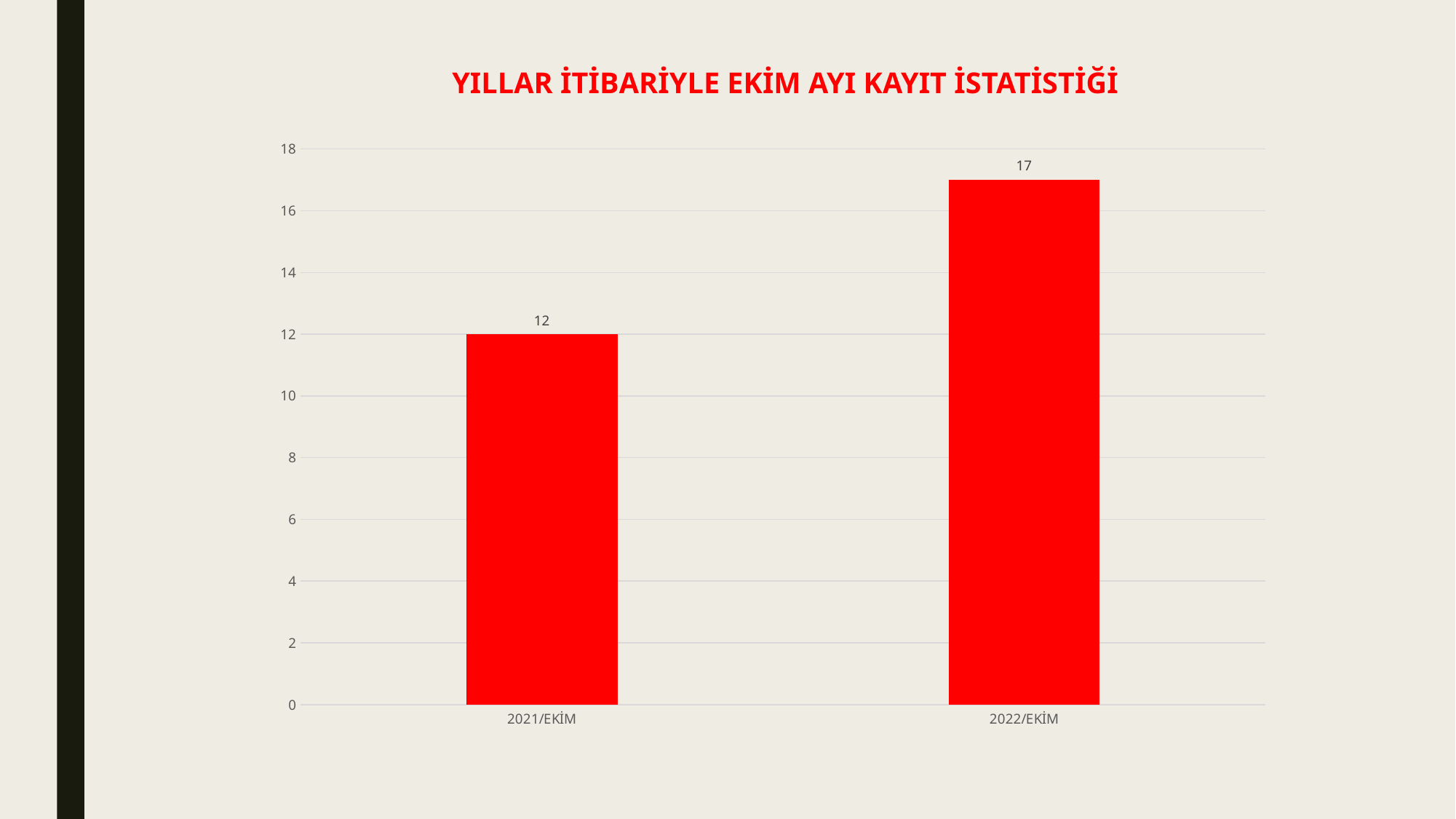
What is the difference between the values for 2022/EKİM and 2021/EKİM? 5 Which category has the lowest value? 2021/EKİM What is the title of the chart? YILLAR İTİBARİYLE EKİM AYI KAYIT İSTATİSTİĞİ Do the values rise or fall from 2021/EKİM to 2022/EKİM? rise Which category has the highest value? 2022/EKİM Is the value for 2022/EKİM greater or less than 16? greater Is the value for 2021/EKİM greater or less than 14? less What is the value for 2021/EKİM? 12 What kind of chart is shown on the slide? bar chart Which is larger, the value for 2021/EKİM or the value for 2022/EKİM? 2022/EKİM How many categories are shown on the x axis? 2 What is the value for 2022/EKİM? 17